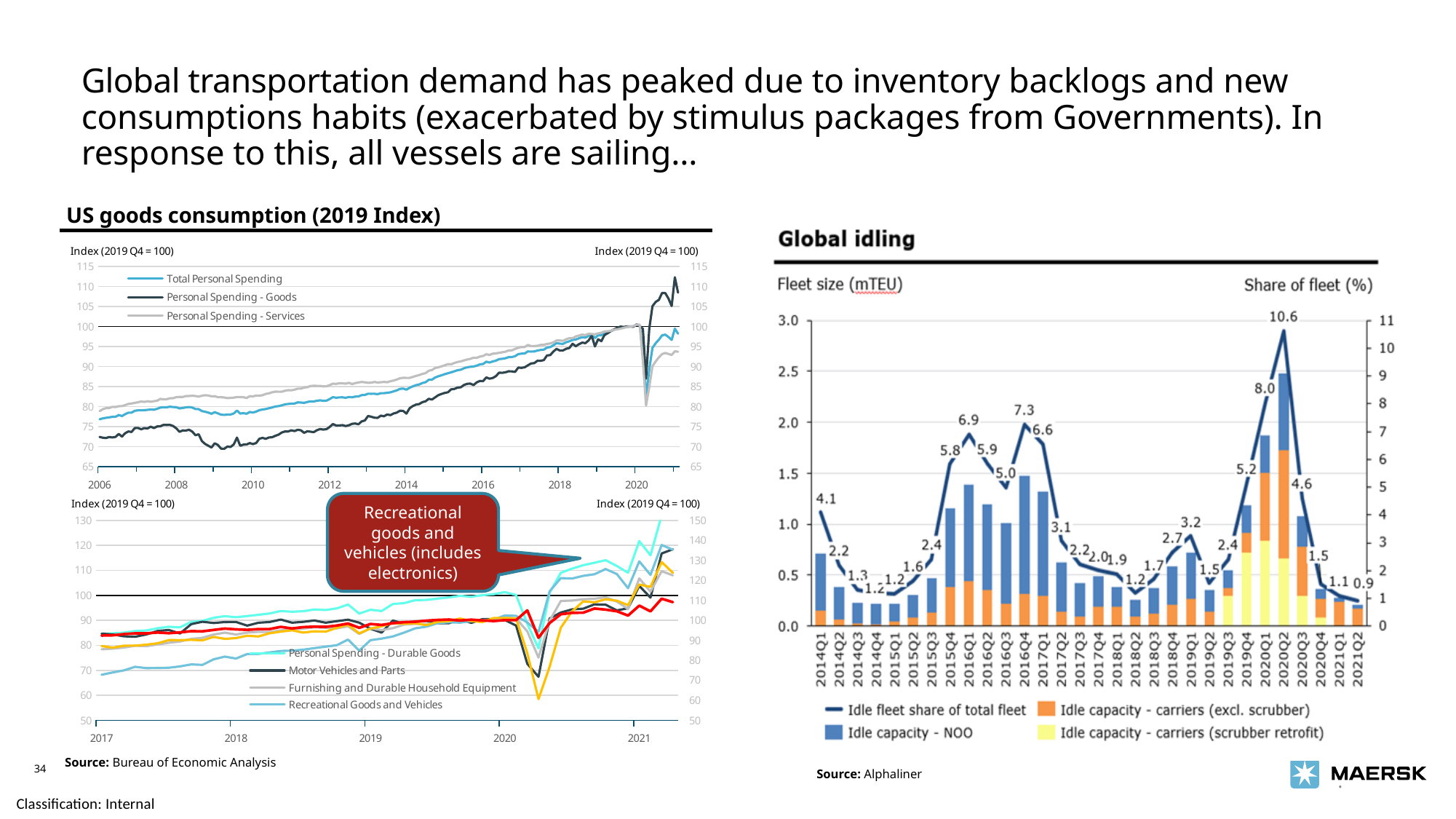
On the Global idling chart, how many entries does the legend list? 4 On the Global idling chart, in which quarter is the idle fleet share of total fleet lowest? 2021Q2 On the Global idling chart, in which quarter is the idle fleet share of total fleet highest? 2020Q2 On the Global idling chart, what is the idle fleet share of total fleet in 2016Q4? 7.3 On the Global idling chart, what is the idle fleet share of total fleet in 2020Q2? 10.6 On the Global idling chart, what is the difference between the idle fleet share in 2020Q2 and in 2020Q1? 2.6 On the Global idling chart, which quarter has a higher idle fleet share: 2016Q1 or 2019Q4? 2016Q1 What kind of chart is the top US goods consumption chart? Line chart On the top US goods consumption chart, how many series does the legend list? 3 On the Global idling chart, what is the idle fleet share of total fleet in 2014Q1? 4.1 On the top US goods consumption chart, is the value for Personal Spending - Goods in 2009 greater or less than 75? less On the Global idling chart, how many quarters are shown on the x axis? 30